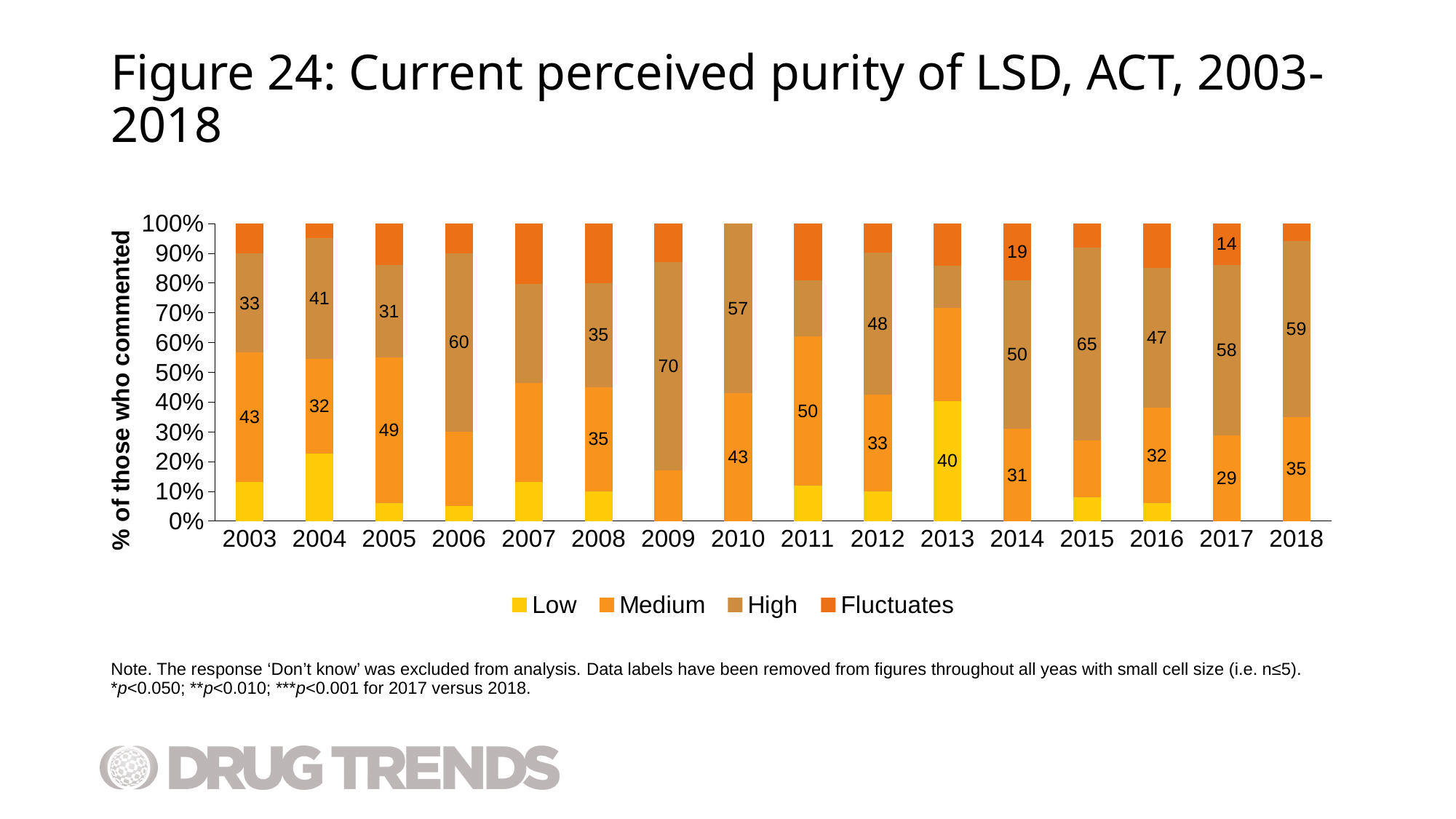
What percentage of respondents rated LSD purity as 'High' in 2009? 70 How many series does the legend list? 4 In 2014, what is the difference between the 'High' and 'Medium' values? 19 What is the value of the 'Fluctuates' segment in 2014? 19 In 2018, which is larger: the 'High' segment or the 'Medium' segment? High Among the labelled 'Medium' values, which year has the lowest? 2017 What is the label of the y axis? % of those who commented What is the data label for the 'Medium' segment in 2005? 49 Among the labelled 'High' values, which year has the highest? 2009 What is the value of the 'Low' segment in 2013? 40 How many years are shown on the x axis? 16 What kind of chart is shown on the slide? Stacked bar chart